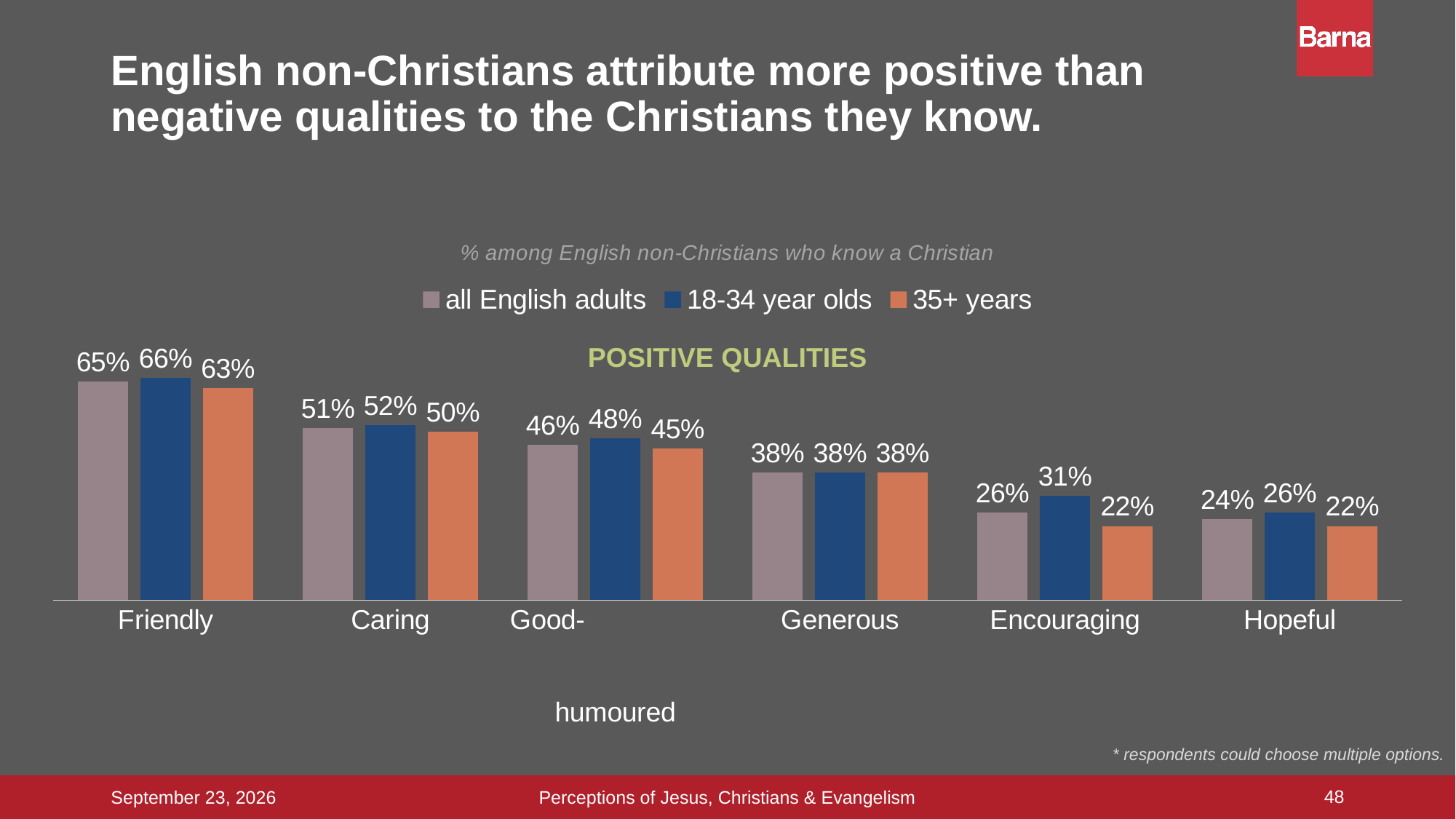
How many series does the legend list? 3 Which is larger for 'Caring': the value for 18-34 year olds or for 35+ years? 18-34 year olds What is the value for 18-34 year olds for 'Encouraging'? 31% How many qualities are shown on the x axis? 6 Which quality has the highest value for all English adults? Friendly What is the value for 35+ years for 'Good-humoured'? 45% What percentage of all English adults attribute the quality 'Friendly' to the Christians they know? 65% What is the heading shown above the bars in the chart? POSITIVE QUALITIES What is the difference between the 18-34 year olds and 35+ years values for 'Encouraging'? 9% What kind of chart is shown on the slide? Bar chart Which quality has the lowest value for all English adults? Hopeful Do the values for all English adults rise or fall from 'Friendly' to 'Hopeful'? Fall